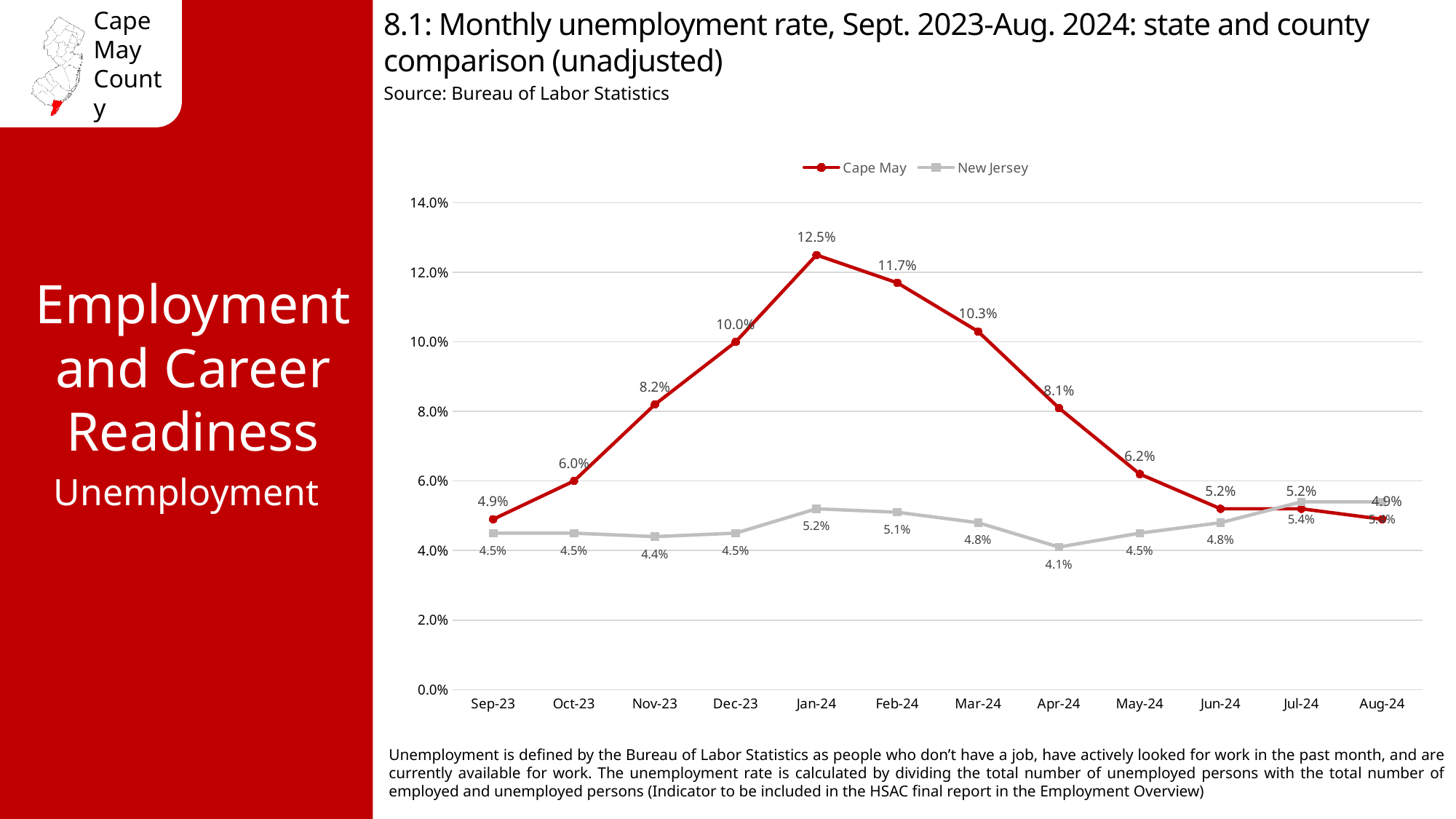
What was the Cape May unemployment rate in Jan-24? 12.5% Is the Cape May unemployment rate in Feb-24 greater or less than 10.0%? greater Did the Cape May unemployment rate rise or fall from Jan-24 to May-24? Fall What kind of chart is shown on the slide? Line chart What is the difference between the Cape May and New Jersey unemployment rates in Jan-24? 7.3% Which had the higher unemployment rate in Mar-24, Cape May or New Jersey? Cape May In which month did Cape May have its highest unemployment rate? Jan-24 What was the New Jersey unemployment rate in Apr-24? 4.1% In which month did New Jersey have its lowest unemployment rate? Apr-24 How many series does the legend list? 2 How many months are shown on the x axis? 12 What was the Cape May unemployment rate in Dec-23? 10.0%